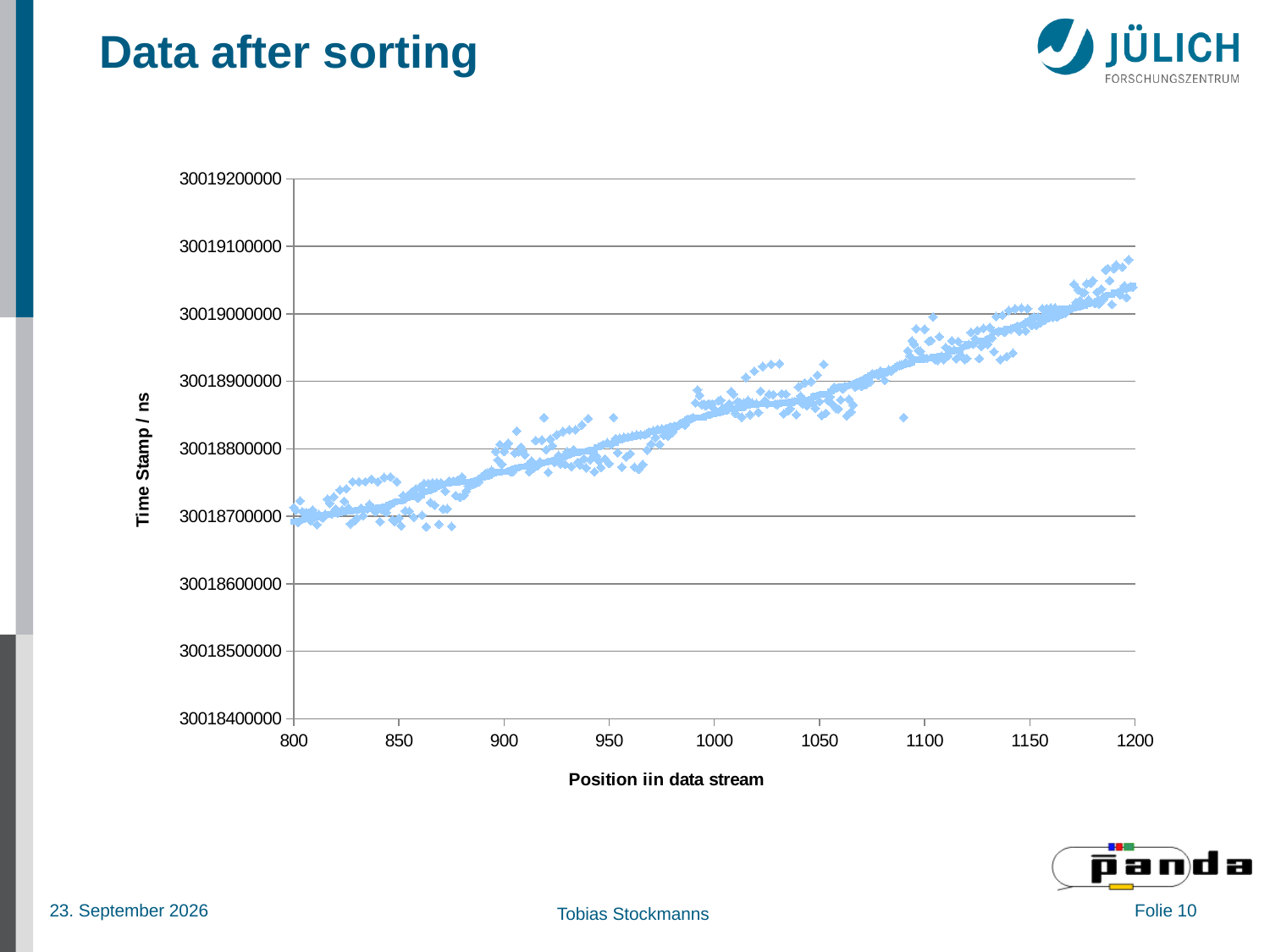
What is the lowest value shown on the x axis? 800 Are the time stamp values at position 1100 greater or less than 30018900000? greater What kind of chart is shown on the slide? scatter plot Are the time stamp values at position 1150 greater or less than 30019100000? less Are the time stamp values near position 1050 greater or less than 30019000000? less What is the title of the chart's y axis? Time Stamp / ns Do the time stamp values rise or fall as the position in the data stream increases from 800 to 1200? rise What is the title of the chart's x axis? Position iin data stream